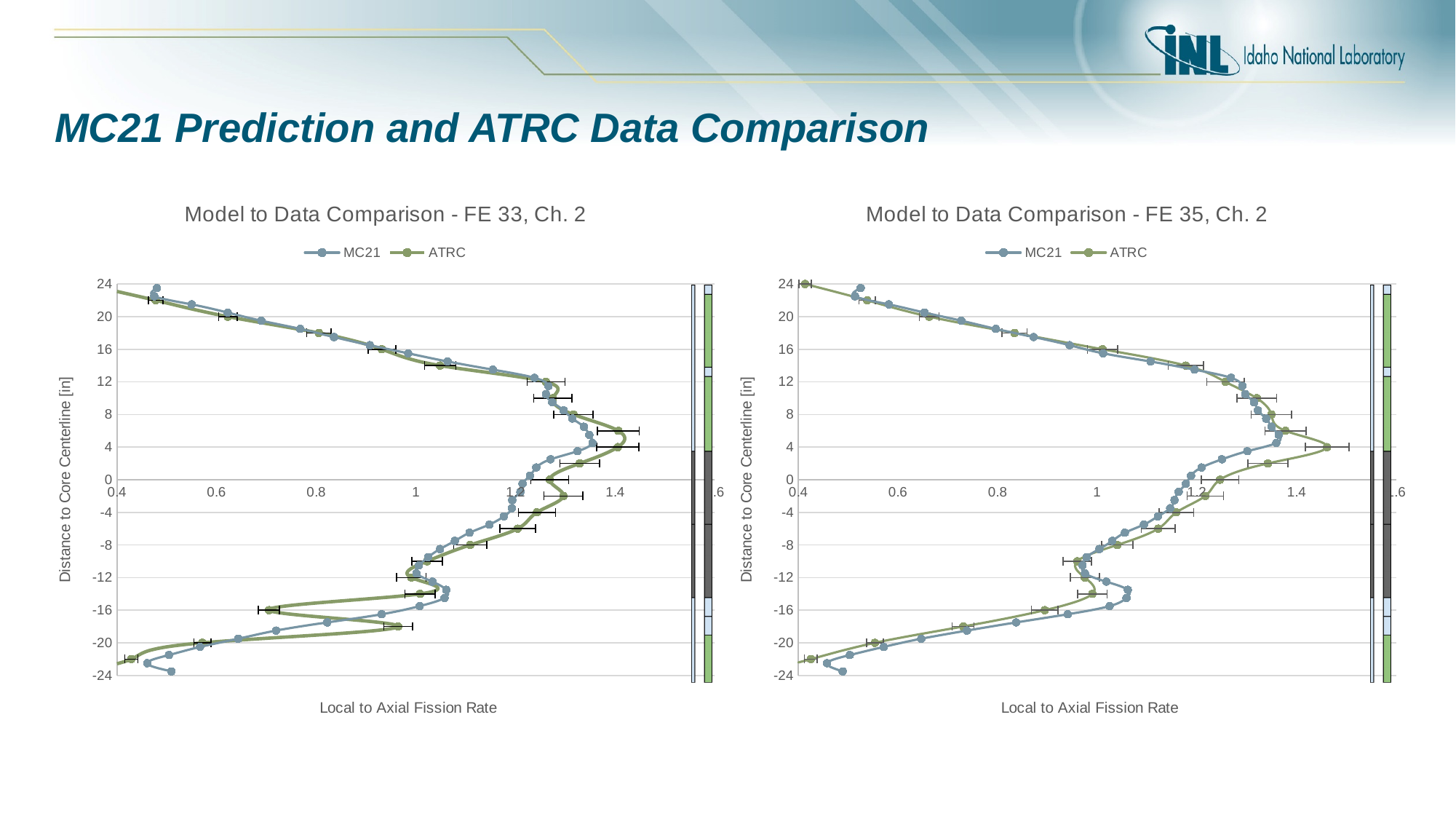
What is the x-axis label of the 'Model to Data Comparison - FE 35, Ch. 2' chart? Local to Axial Fission Rate In the 'Model to Data Comparison - FE 35, Ch. 2' chart, as the distance from core centerline goes from 24 in down to 4 in, does the MC21 value rise or fall? rise In the 'Model to Data Comparison - FE 33, Ch. 2' chart, is the ATRC value at 4 in greater or less than 1.2? greater In the 'Model to Data Comparison - FE 35, Ch. 2' chart, is the MC21 value at 20 in greater or less than 0.8? less In the 'Model to Data Comparison - FE 35, Ch. 2' chart, is the ATRC value at 4 in greater or less than 1.4? greater How many series does the legend of the 'Model to Data Comparison - FE 35, Ch. 2' chart list? 2 What kind of chart is the 'Model to Data Comparison - FE 33, Ch. 2' chart? Line chart In the 'Model to Data Comparison - FE 33, Ch. 2' chart, which series has the larger value at -16 in, MC21 or ATRC? MC21 In the 'Model to Data Comparison - FE 35, Ch. 2' chart, which series has the larger value at 4 in, MC21 or ATRC? ATRC What are the two series named in the legend of the 'Model to Data Comparison - FE 33, Ch. 2' chart? MC21 and ATRC In the 'Model to Data Comparison - FE 35, Ch. 2' chart, at which distance from core centerline does the ATRC series reach its highest value? 4